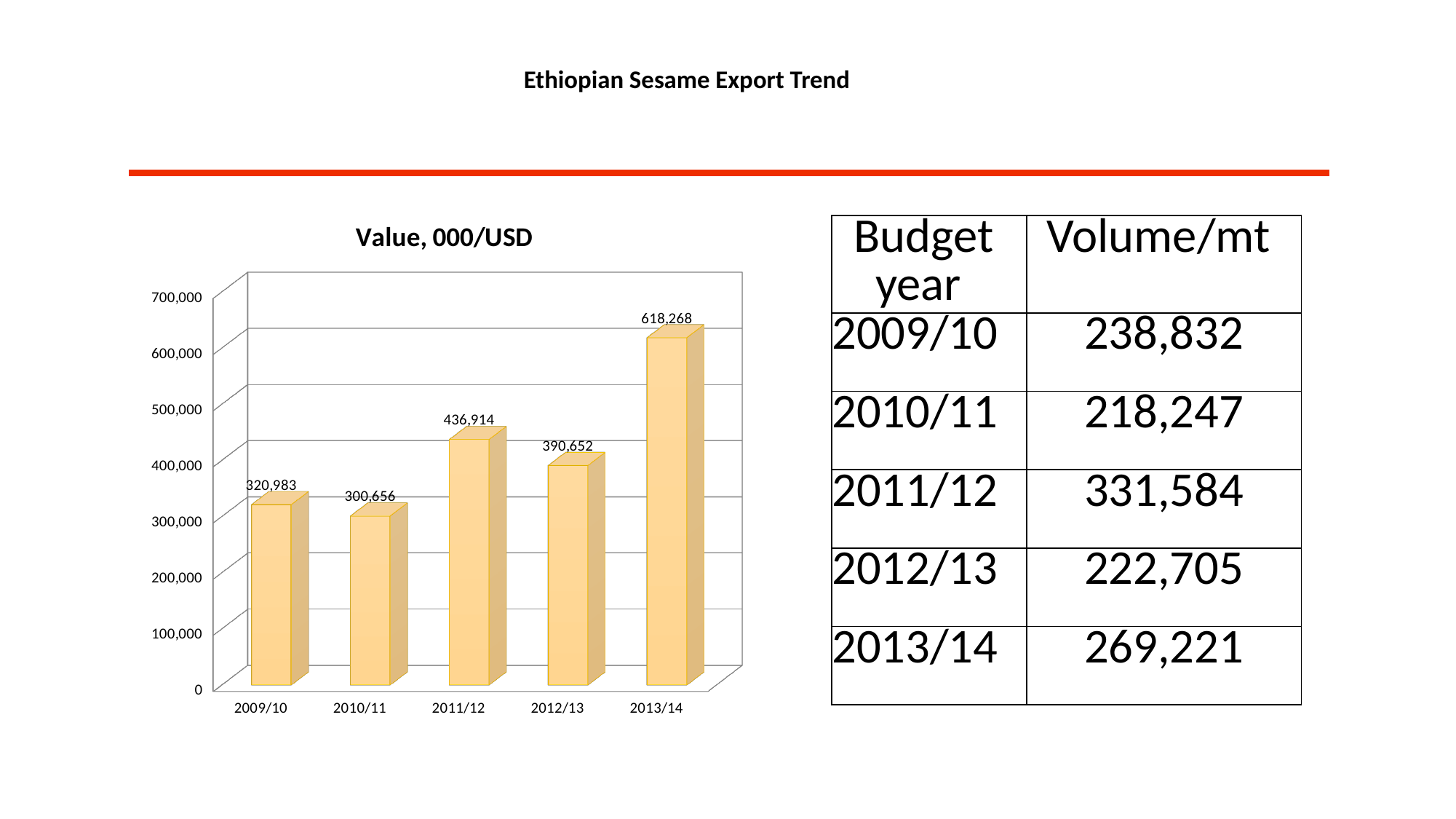
Is the value for 2012/13 greater or less than 400,000? less Which is larger, the value for 2011/12 or the value for 2012/13? 2011/12 What is the title of the chart? Value, 000/USD What kind of chart is shown on the slide? bar chart What is the value for 2013/14 in the chart? 618,268 Which year has the highest value in the chart? 2013/14 What is the value for 2011/12 in the chart? 436,914 What is the value for 2009/10 in the chart? 320,983 What is the difference between the values for 2011/12 and 2010/11? 136,258 Which year has the lowest value in the chart? 2010/11 What is the difference between the values for 2013/14 and 2012/13? 227,616 How many years are shown on the x axis of the chart? 5